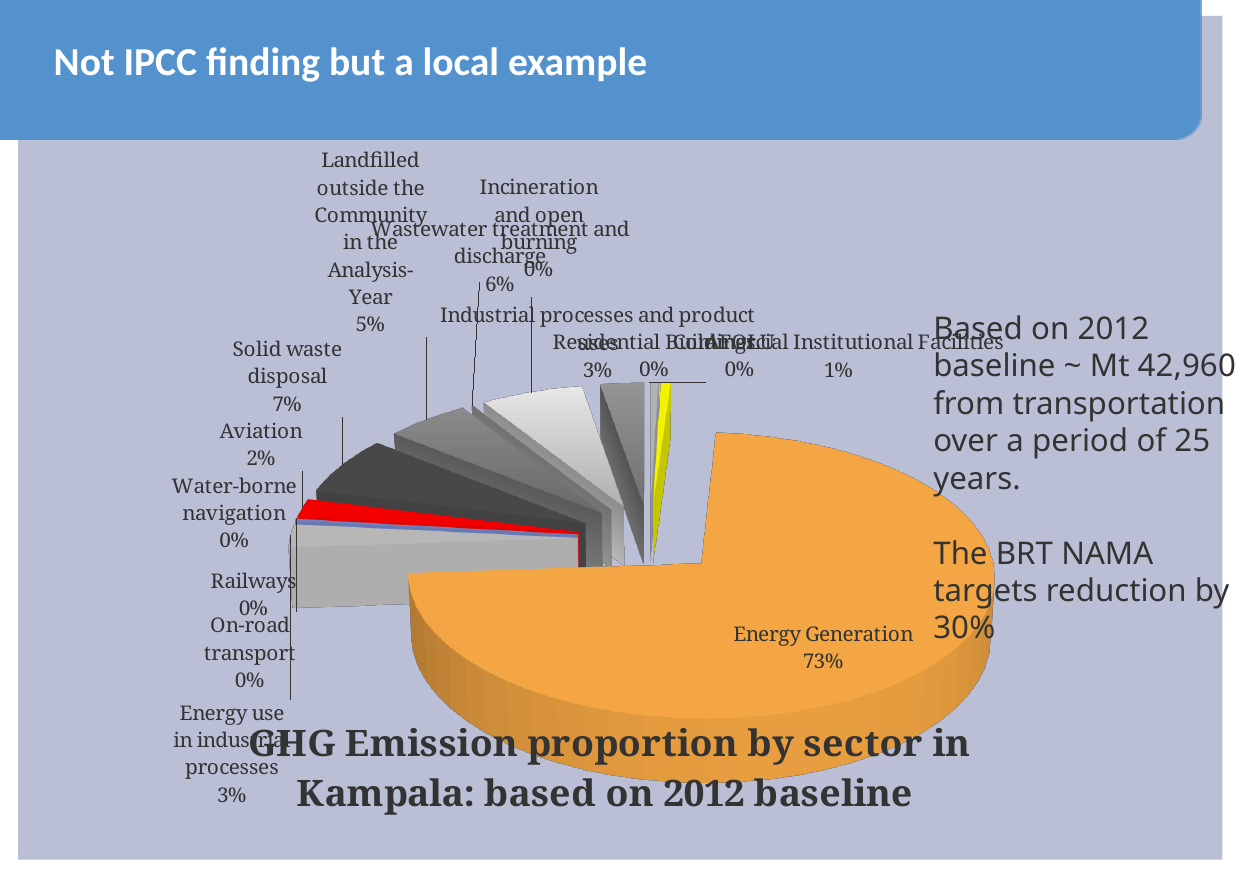
What share of GHG emissions does Energy Generation account for? 73% Which has a larger share, Solid waste disposal or Aviation? Solid waste disposal What is the title of the chart? GHG Emission proportion by sector in Kampala: based on 2012 baseline What percentage is shown for Solid waste disposal? 7% How many percentage points larger is the Solid waste disposal share than the Wastewater treatment and discharge share? 1 What percentage is shown for Aviation? 2% What percentage is shown for Wastewater treatment and discharge? 6% What percentage is shown for Landfilled outside the Community in the Analysis-Year? 5% What percentage is shown for Railways? 0% What kind of chart is shown on the slide? pie chart What percentage is shown for Energy use in industrial processes? 3% Which sector has the largest share of GHG emissions? Energy Generation